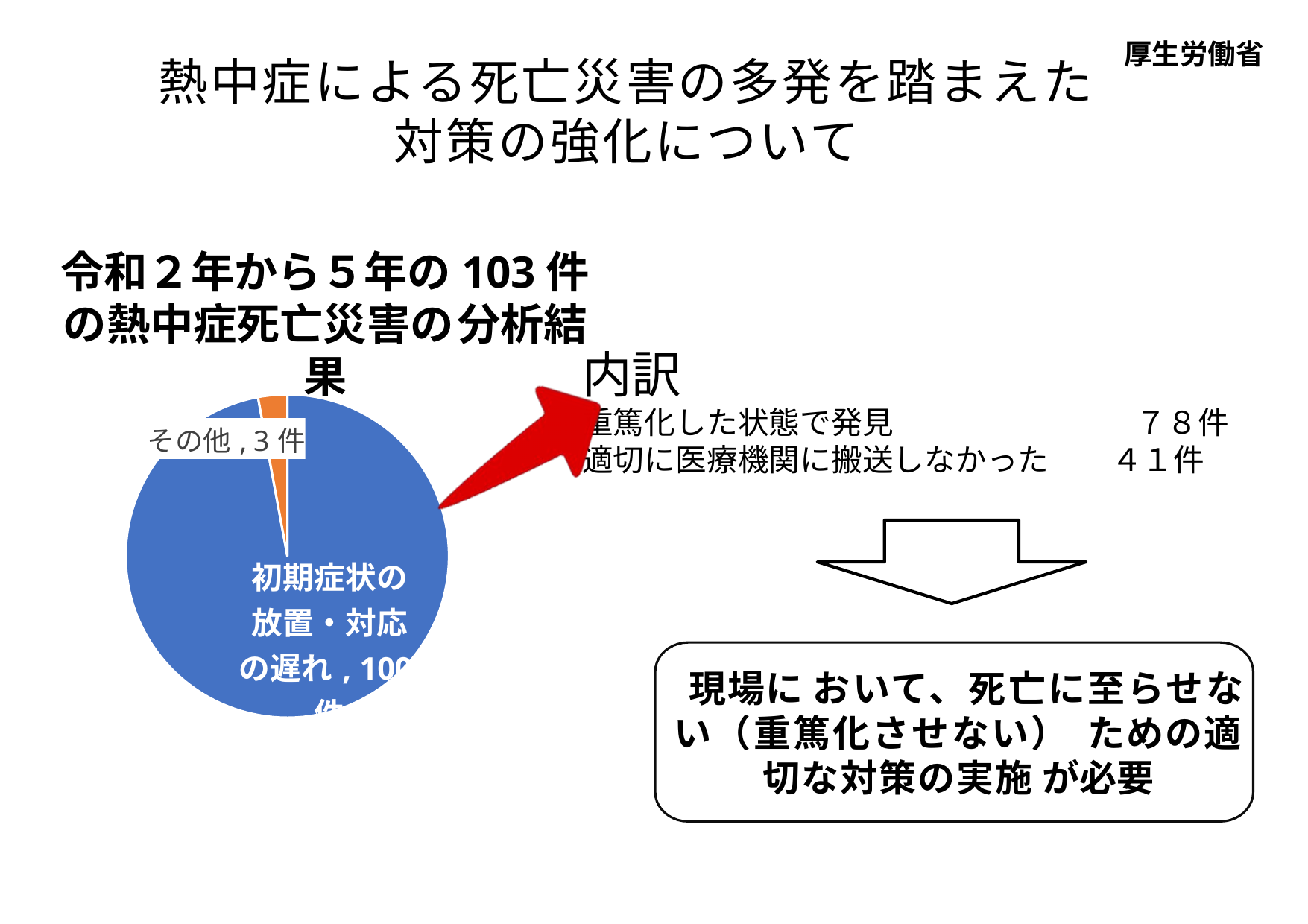
What is the difference between the values for 初期症状の放置・対応の遅れ and その他 in the pie chart? 97件 What is the total number of cases represented in the pie chart? 103件 What is the value for 初期症状の放置・対応の遅れ in the pie chart? 100件 What colour is the その他 slice in the pie chart? Orange Which is larger in the pie chart, 初期症状の放置・対応の遅れ or その他? 初期症状の放置・対応の遅れ Which category has the largest slice in the pie chart? 初期症状の放置・対応の遅れ What is the title of the pie chart? 令和２年から５年の103件の熱中症死亡災害の分析結果 What is the value for その他 in the pie chart? 3件 Which category has the smallest slice in the pie chart? その他 What kind of chart is shown on the slide? Pie chart How many slices does the pie chart have? 2